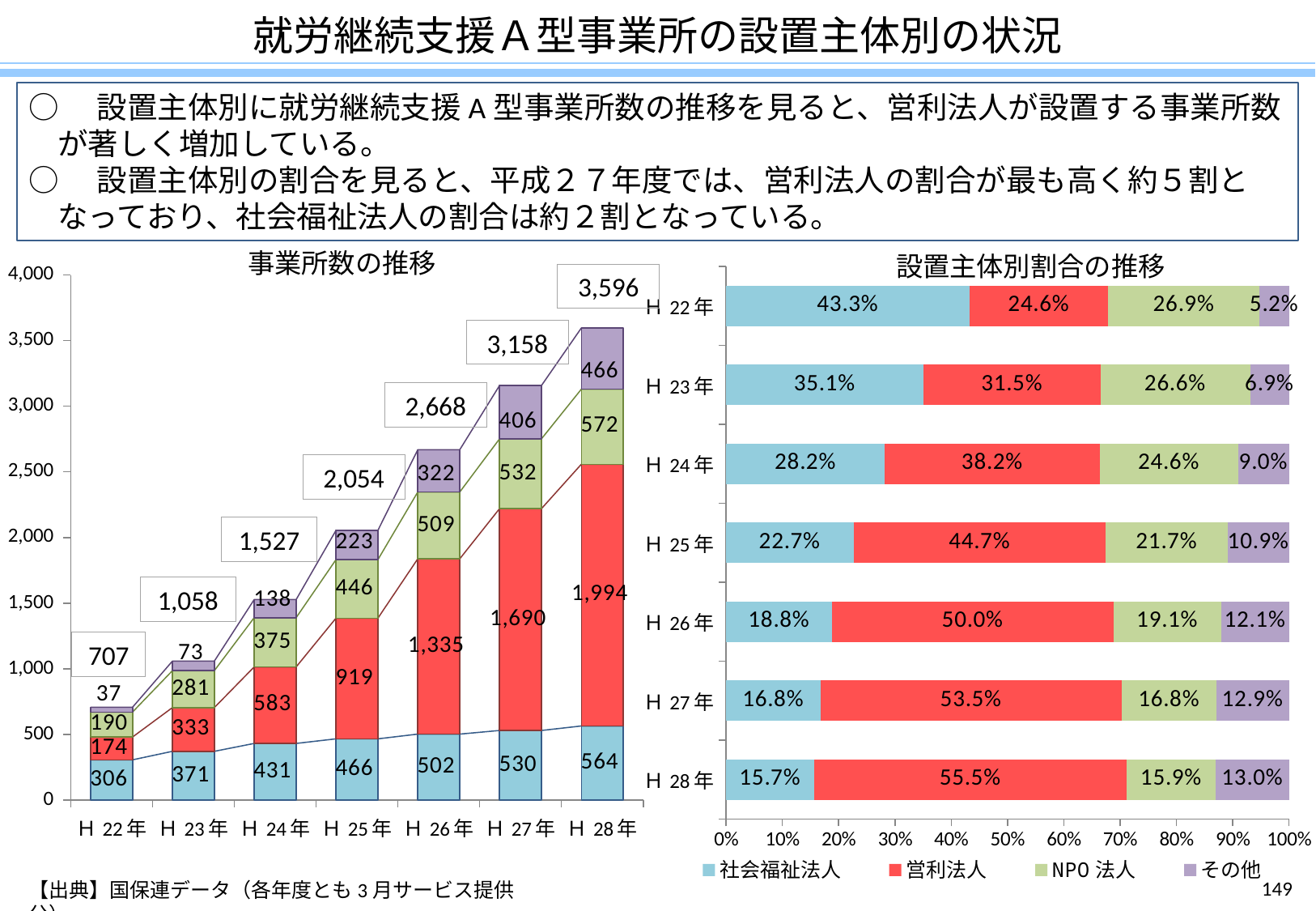
In the 設置主体別割合の推移 chart, which is larger in H 24年: the share of 営利法人 or the share of NPO法人? 営利法人 In the 事業所数の推移 chart, what is the value for 社会福祉法人 in H 22年? 306 In the 設置主体別割合の推移 chart, which year has the highest share for 社会福祉法人? H 22年 In the 事業所数の推移 chart, how many years are shown on the x axis? 7 In the 事業所数の推移 chart, does the total number of establishments rise or fall from H 22年 to H 28年? rise In the 設置主体別割合の推移 chart, which year has the lowest share for その他? H 22年 In the 事業所数の推移 chart, what is the difference between the 営利法人 values for H 28年 and H 27年? 304 What kind of chart is the 設置主体別割合の推移 chart? bar chart In the 設置主体別割合の推移 chart, what is the share of 営利法人 in H 27年? 53.5% In the 事業所数の推移 chart, what is the total number of establishments in H 28年? 3,596 How many series does the legend of the 設置主体別割合の推移 chart list? 4 In the 事業所数の推移 chart, what is the value for 営利法人 in H 26年? 1,335